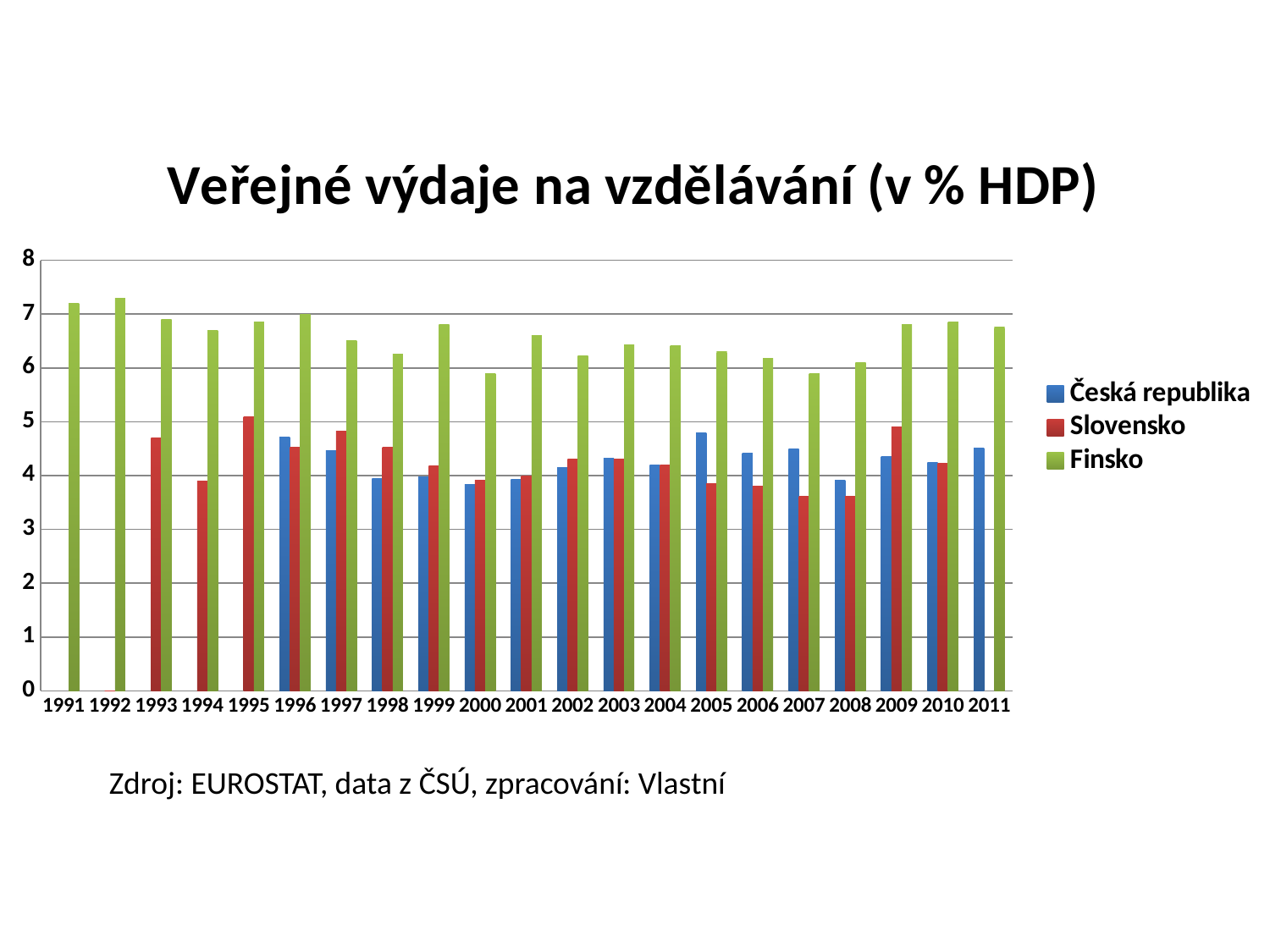
What kind of chart is shown on the slide? bar chart In which year is the value for Slovensko highest? 1995 How many years are shown on the x axis? 21 Is the value for Česká republika in 2005 greater or less than 4? greater Is the value for Finsko in 1991 greater or less than 7? greater In 2005, which is larger: the value for Česká republika or for Slovensko? Česká republika What is the title of the chart? Veřejné výdaje na vzdělávání (v % HDP) Is the value for Slovensko in 2008 greater or less than 4? less Does the value for Finsko rise or fall from 1991 to 2000? fall How many series does the legend list? 3 Which series has the highest value in 2011? Finsko